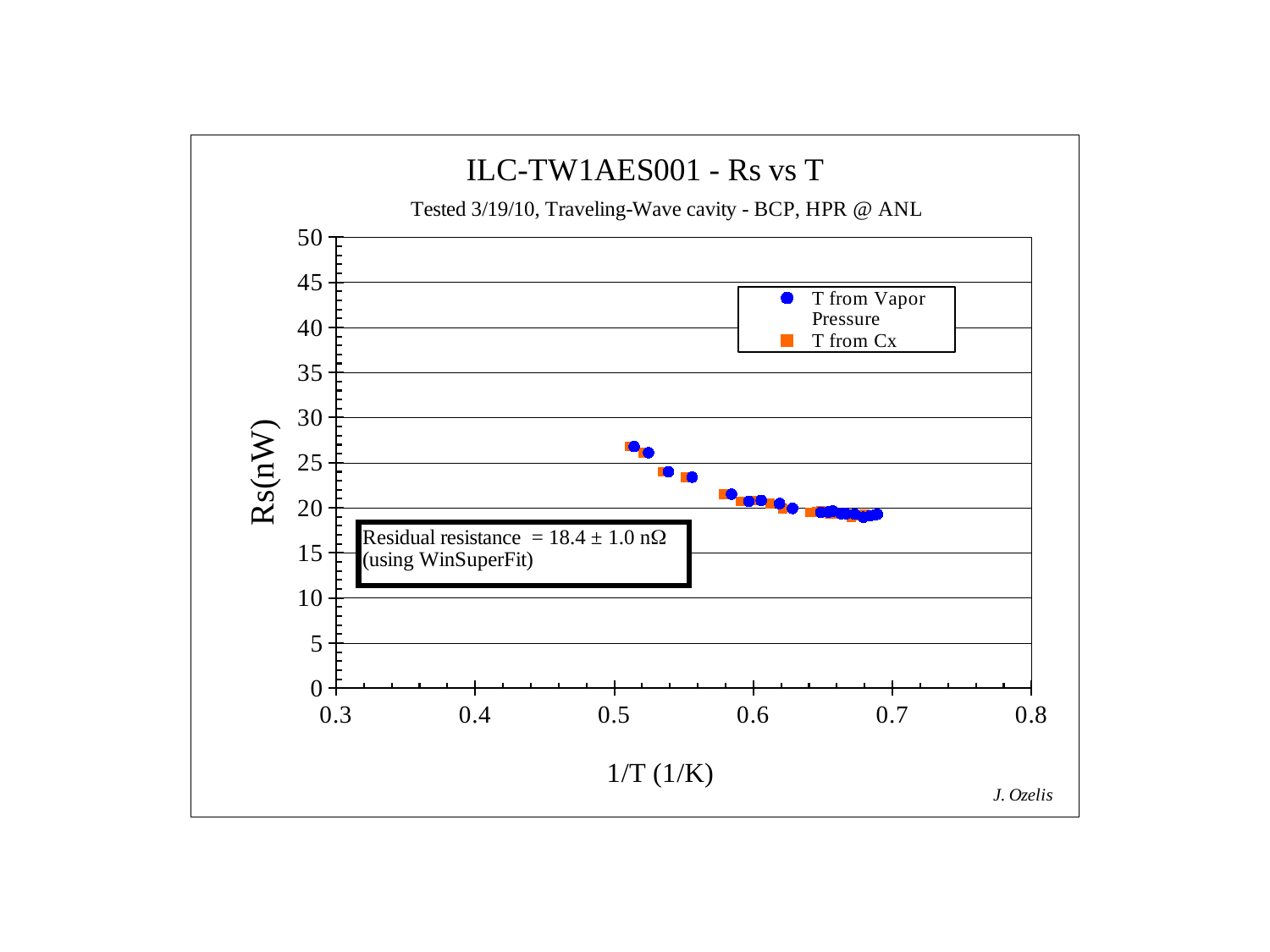
What are the two series named in the legend? T from Vapor Pressure; T from Cx Is the highest plotted Rs value greater or less than 30? less Is the largest 1/T value at which a point is plotted greater or less than 0.7? less Is the lowest plotted Rs value greater or less than 15? greater What kind of chart is shown on the slide? Scatter chart How many series does the legend list? 2 What is the title of the chart? ILC-TW1AES001 - Rs vs T Do the Rs values rise or fall as 1/T increases along the x axis? Fall